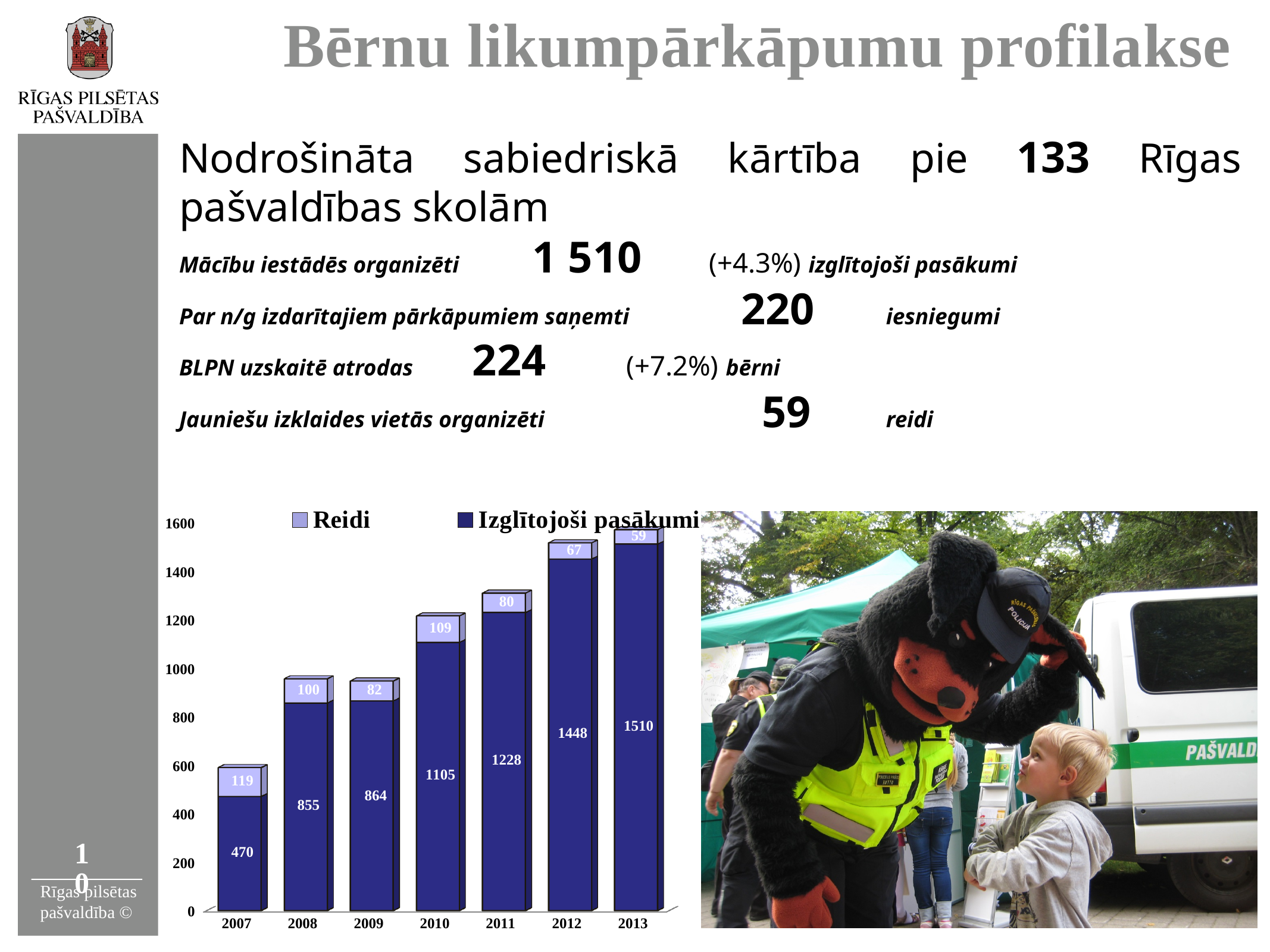
Which year has the lowest value for Reidi? 2013 What kind of chart is shown on the slide? stacked bar chart What is the difference between Izglītojoši pasākumi in 2013 and 2012? 62 Which is larger, Reidi in 2008 or Reidi in 2011? 2008 What is the value of Izglītojoši pasākumi for 2010? 1105 Does the value of Izglītojoši pasākumi rise or fall from 2007 to 2013? rise How many years are shown on the x axis of the chart? 7 What is the value of Reidi for 2007? 119 How many series does the chart legend list? 2 Which legend entry is shown in the darker blue colour? Izglītojoši pasākumi What is the total of the stacked bar for 2007? 589 Which year has the highest value for Izglītojoši pasākumi? 2013